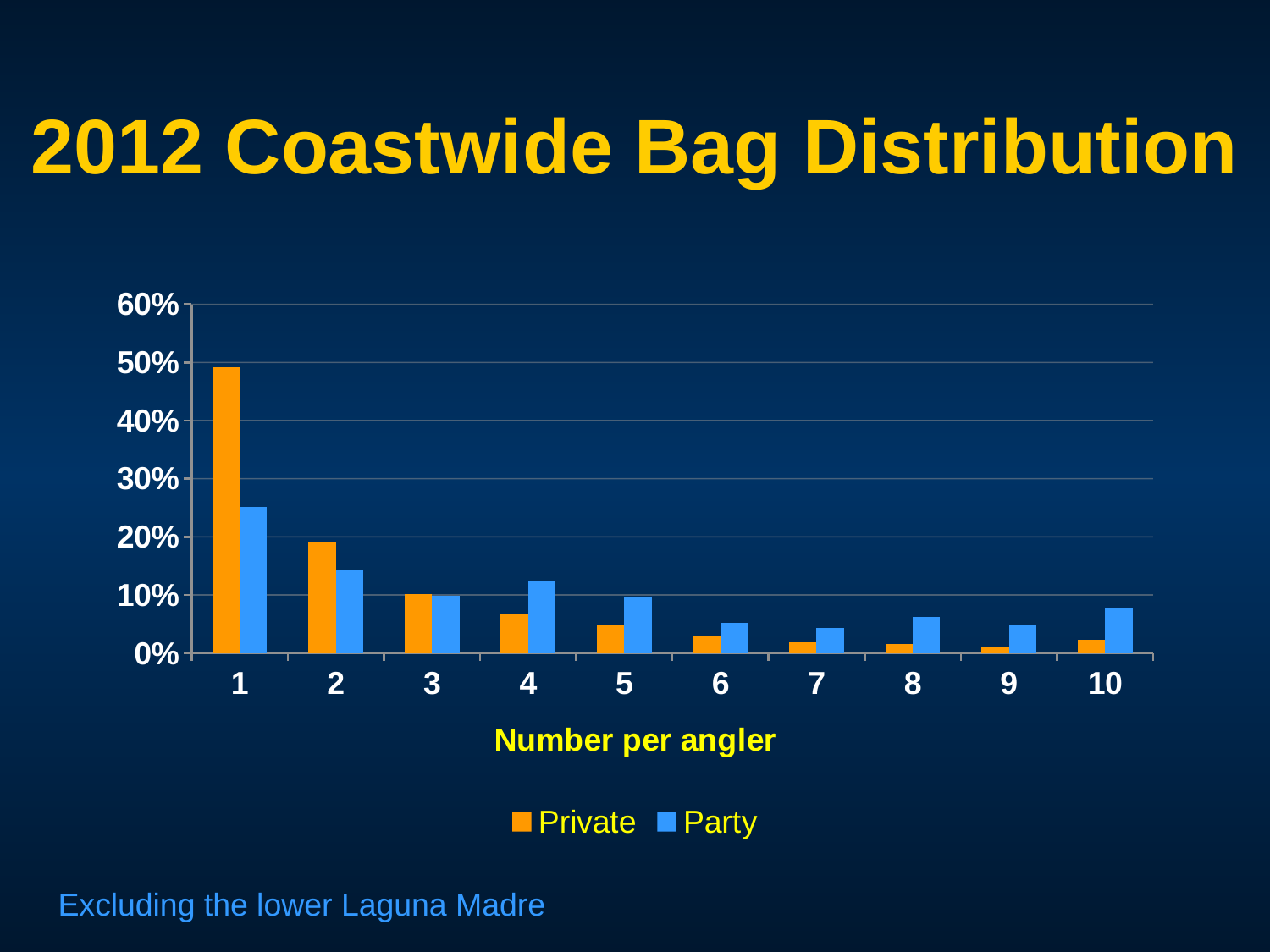
At 4 per angler, which series has the larger value, Private or Party? Party What kind of chart is shown on the slide? bar chart For which number per angler is the Private value highest? 1 Do the Private values generally rise or fall as the number per angler increases from 1 to 9? fall For which number per angler is the Private value lowest? 9 Is the Party value at 1 per angler greater or less than 20%? greater What is the title of the x axis? Number per angler At 1 per angler, which series has the larger value, Private or Party? Private For which number per angler is the Party value highest? 1 How many series does the legend list? 2 Is the Private value at 1 per angler greater or less than 40%? greater How many categories are shown along the x axis? 10